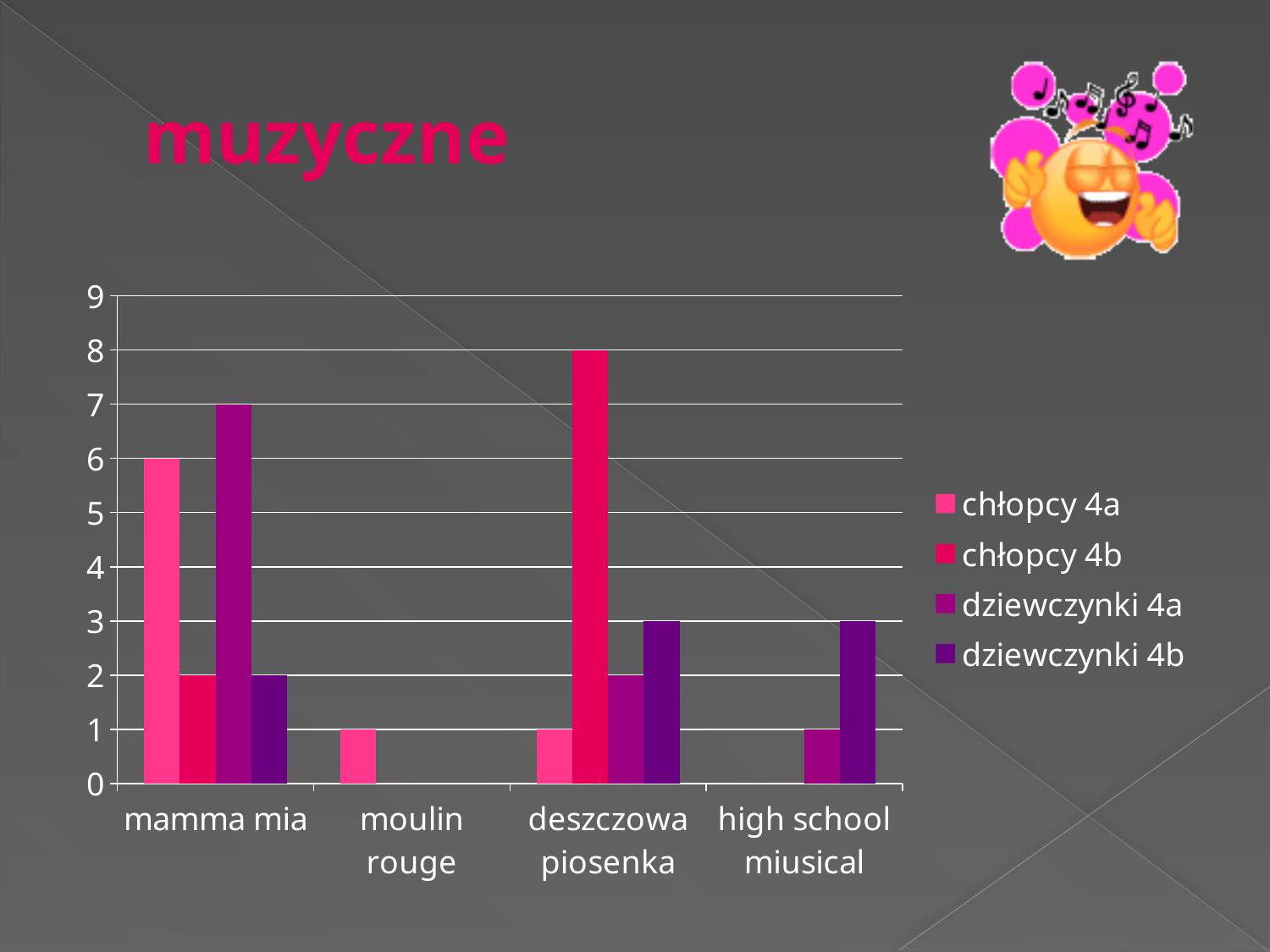
How many categories are shown on the x axis? 4 Which category has the highest value for chłopcy 4a? mamma mia What is the value for chłopcy 4b for deszczowa piosenka? 8 What is the value for dziewczynki 4b for high school miusical? 3 What is the value for chłopcy 4a for mamma mia? 6 Which category has the highest value for chłopcy 4b? deszczowa piosenka What is the title of the slide? muzyczne How many series does the legend list? 4 Which is larger for deszczowa piosenka: dziewczynki 4a or dziewczynki 4b? dziewczynki 4b What kind of chart is shown on the slide? bar chart What is the difference between dziewczynki 4a and chłopcy 4a for mamma mia? 1 What is the value for dziewczynki 4a for mamma mia? 7